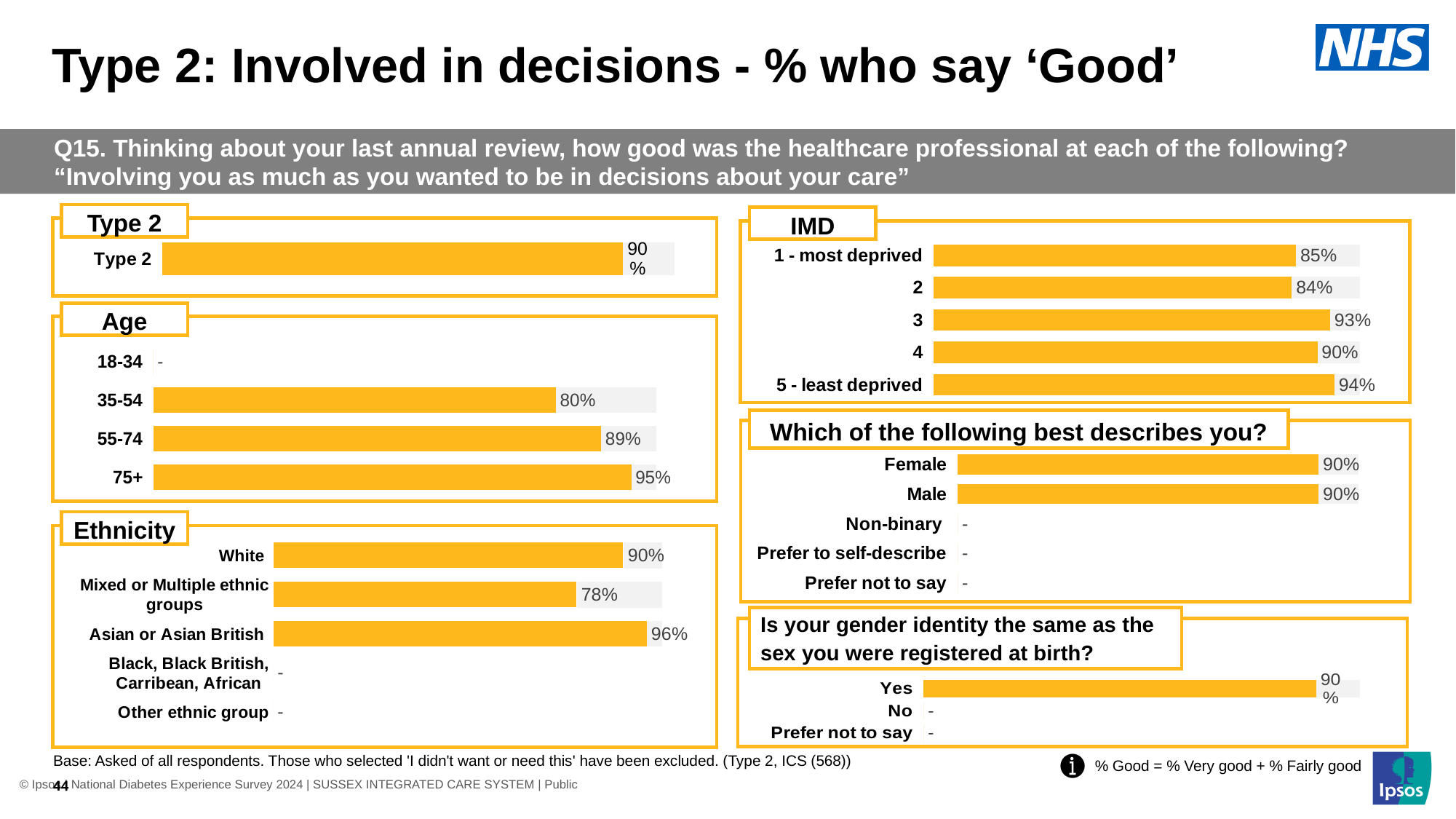
In the Age chart, what is the value for 75+? 95% In the Ethnicity chart, what is the value for Asian or Asian British? 96% What kind of chart is used in the Type 2 section? Bar chart In the IMD chart, what is the value for 1 - most deprived? 85% In the IMD chart, how many categories are shown? 5 In the Age chart, which age group has the lowest value among those with a printed value? 35-54 In the Ethnicity chart, what is the difference between the values for White and Mixed or Multiple ethnic groups? 12 percentage points In the IMD chart, which category has the highest value? 5 - least deprived In the 'Which of the following best describes you?' chart, what is the value for Male? 90% In the IMD chart, which category has the lowest value? 2 In the Age chart, what is the difference between the values for 75+ and 35-54? 15 percentage points In the Ethnicity chart, which group has the highest value? Asian or Asian British